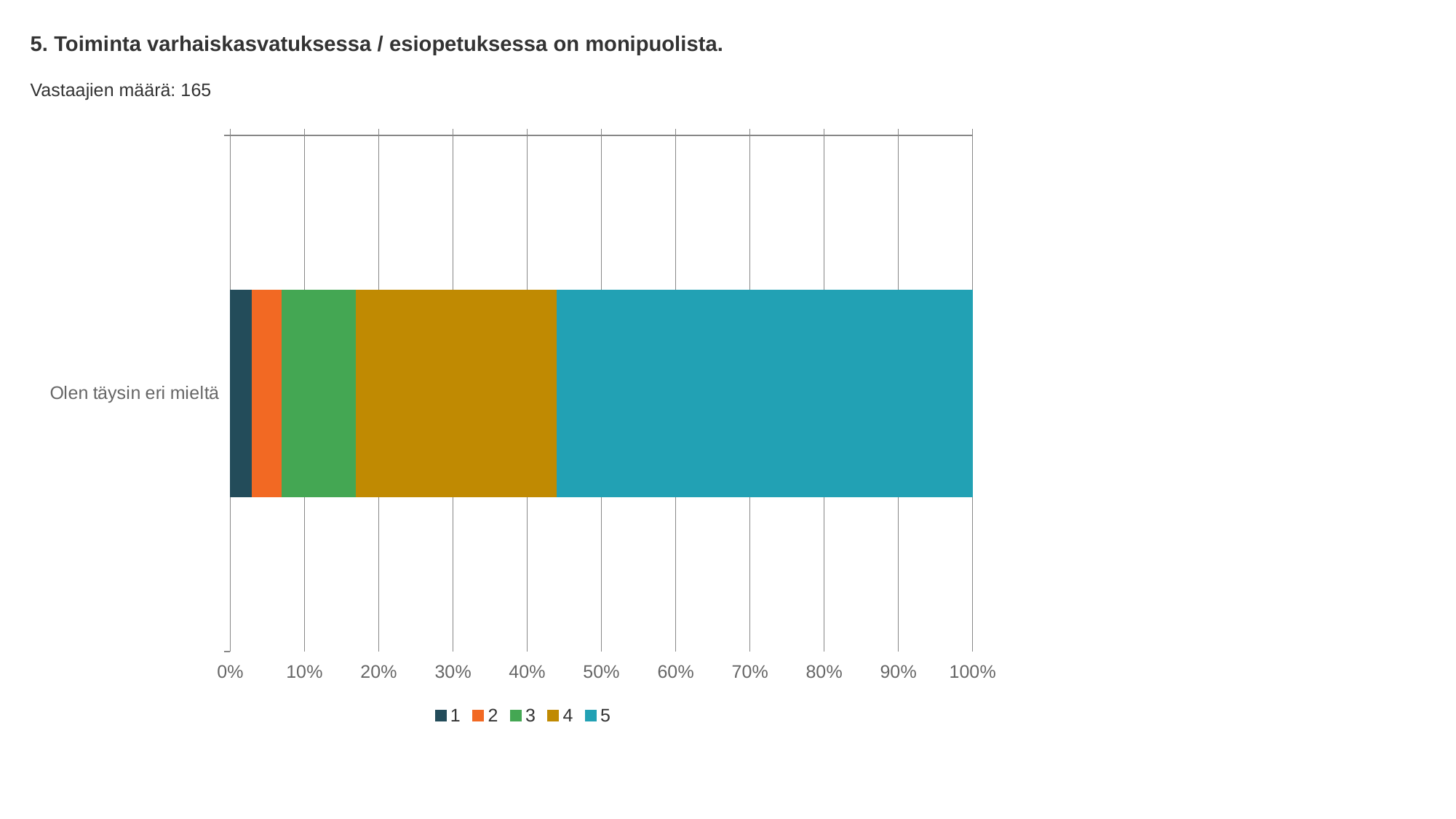
Is the share of series 5 in the bar greater or less than 50%? greater Which series has the larger segment in the bar, 4 or 5? 5 What kind of chart is shown on the slide? stacked bar chart What is the total of the stacked bar for 'Olen täysin eri mieltä'? 100% How many respondents (Vastaajien määrä) are reported on the slide? 165 How many series does the legend list? 5 Which series takes up the largest share of the bar for 'Olen täysin eri mieltä'? 5 Which series has the larger segment in the bar, 3 or 4? 4 Is the share of series 4 in the bar greater or less than 20%? greater How many categories are plotted on the y axis? 1 Is the share of series 4 in the bar greater or less than 30%? less Which series takes up the smallest share of the bar for 'Olen täysin eri mieltä'? 1